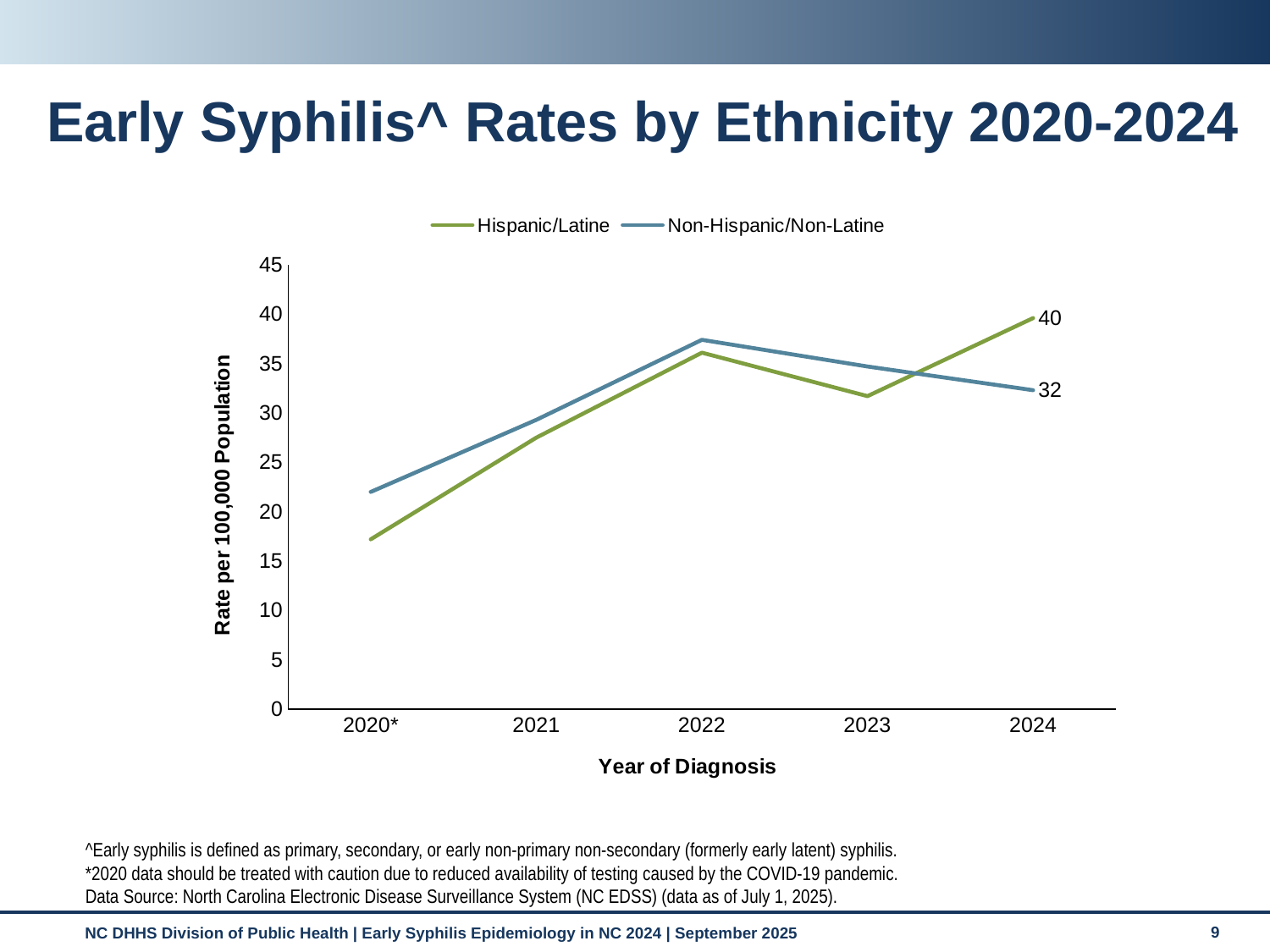
What is the Hispanic/Latine early syphilis rate in 2024? 40 Is the Non-Hispanic/Non-Latine rate in 2022 greater or less than 35? greater How many series does the legend list? 2 In which year is the Non-Hispanic/Non-Latine rate highest? 2022 What is the title of the y axis? Rate per 100,000 Population What is the difference between the Hispanic/Latine and Non-Hispanic/Non-Latine rates in 2024? 8 What is the Non-Hispanic/Non-Latine early syphilis rate in 2024? 32 In 2024, which group has the higher early syphilis rate? Hispanic/Latine What kind of chart is shown on the slide? line chart Is the Hispanic/Latine rate in 2020* greater or less than 20? less How many years of diagnosis are shown on the x axis? 5 Is the Hispanic/Latine rate in 2021 greater or less than 25? greater